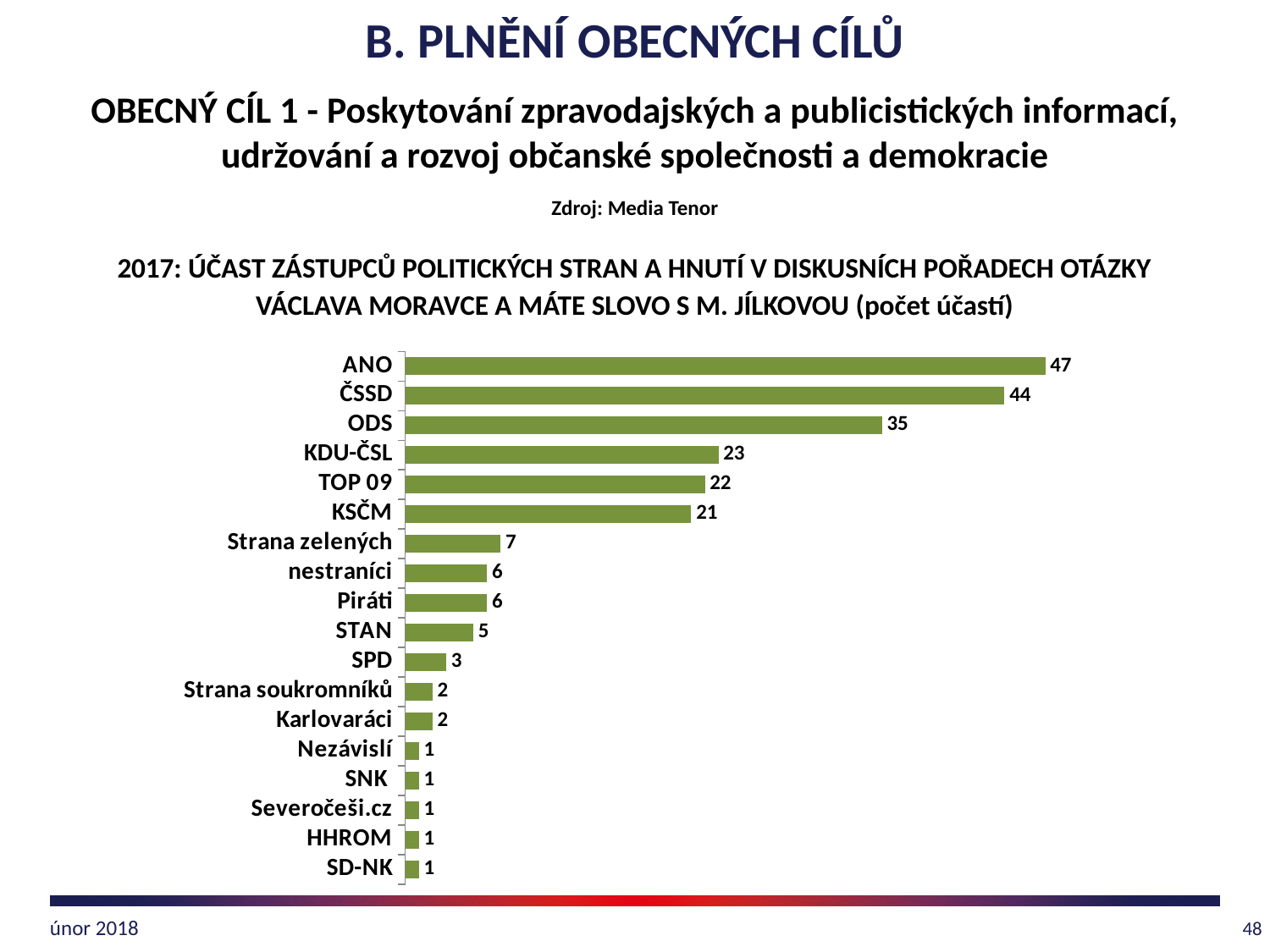
Which has a larger value, TOP 09 or KSČM? TOP 09 Which party has the highest number of participations? ANO What is the value for KDU-ČSL? 23 What is the difference between the values for ČSSD and ODS? 9 What is the value for ANO? 47 What is the value for SPD? 3 What is the value for Strana zelených? 7 What is the source cited for the chart data? Media Tenor What is the difference between the values for ANO and KSČM? 26 How many parties or movements are listed in the chart? 18 What kind of chart is shown on the slide? bar chart How many parties have a value of 1? 5